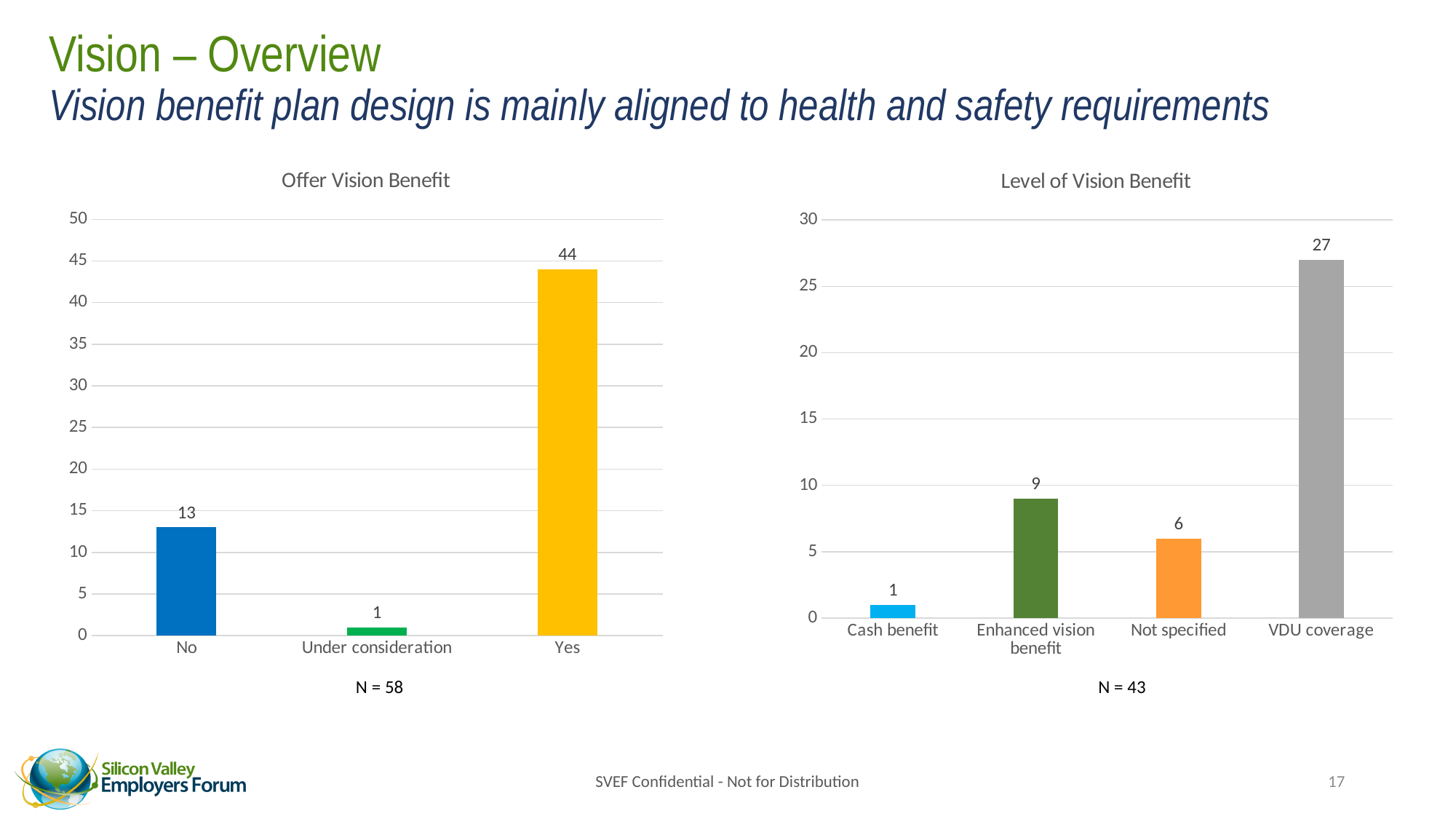
In the 'Level of Vision Benefit' chart, which category has the highest value? VDU coverage In the 'Offer Vision Benefit' chart, what is the value for Yes? 44 In the 'Offer Vision Benefit' chart, which category has the lowest value? Under consideration In the 'Level of Vision Benefit' chart, which is larger, Not specified or Cash benefit? Not specified In the 'Level of Vision Benefit' chart, what is the value for Enhanced vision benefit? 9 In the 'Level of Vision Benefit' chart, what is the difference between VDU coverage and Enhanced vision benefit? 18 What is the N value shown under the 'Offer Vision Benefit' chart? N = 58 What kind of chart is the 'Level of Vision Benefit' chart? Bar chart In the 'Level of Vision Benefit' chart, what is the value for VDU coverage? 27 In the 'Offer Vision Benefit' chart, what is the difference between the values for Yes and No? 31 In the 'Offer Vision Benefit' chart, how many categories are shown? 3 In the 'Offer Vision Benefit' chart, what is the value for No? 13